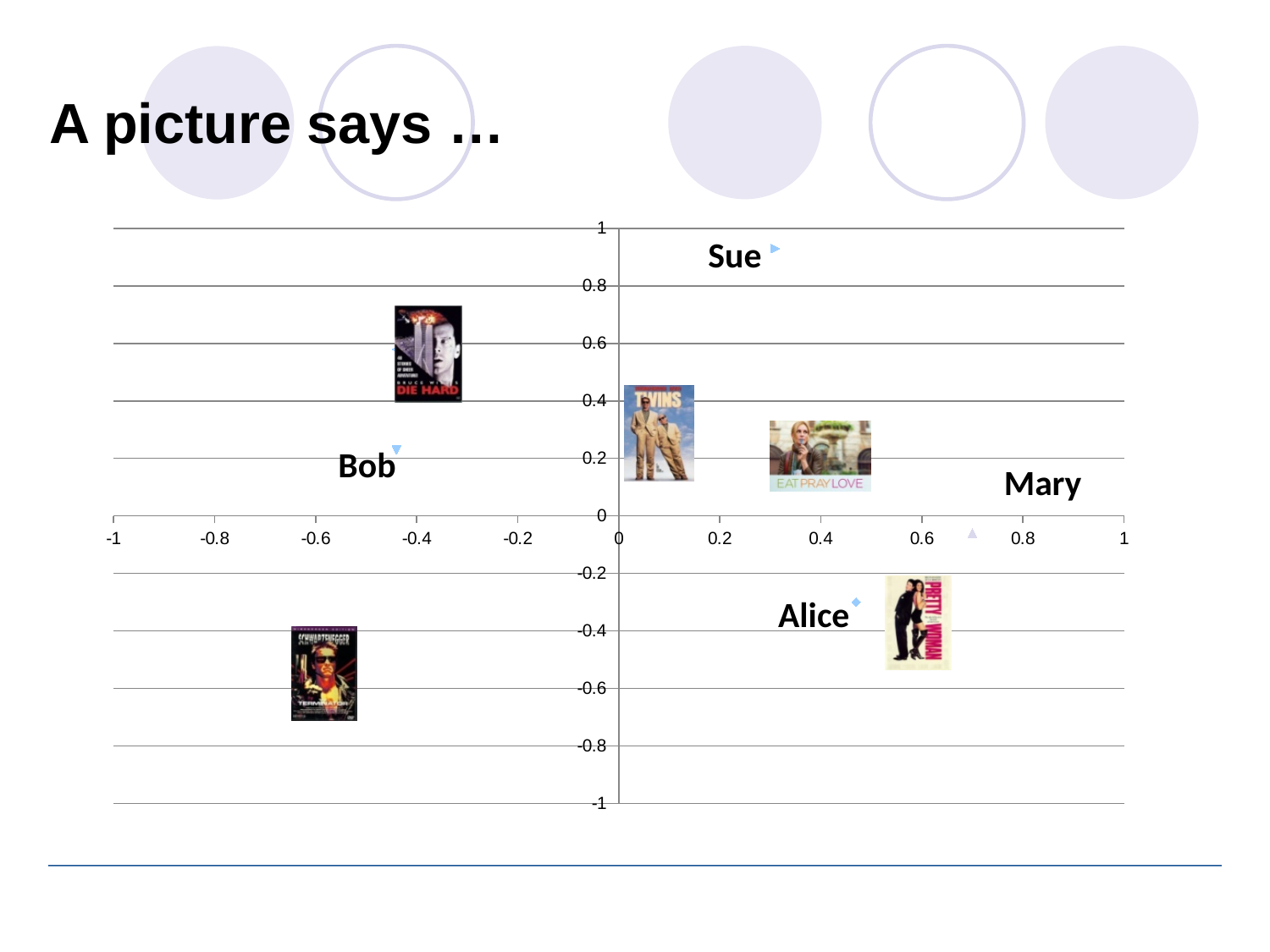
Is the vertical (y) value for Sue greater or less than 0.8? greater Which named point has the highest vertical (y) position on the chart? Sue Which point is positioned higher on the vertical axis, Sue or Alice? Sue What are the minimum and maximum values shown on the horizontal axis? -1 and 1 Which named point has the lowest vertical (y) position on the chart? Alice How many named people are plotted as points on the chart? 4 Which named point is furthest to the left on the horizontal axis? Bob Is the horizontal (x) value for Bob greater or less than -0.2? less Is the vertical (y) value for Alice greater or less than -0.2? less What kind of chart is shown on the slide? scatter chart Which named point is furthest to the right on the horizontal axis? Mary